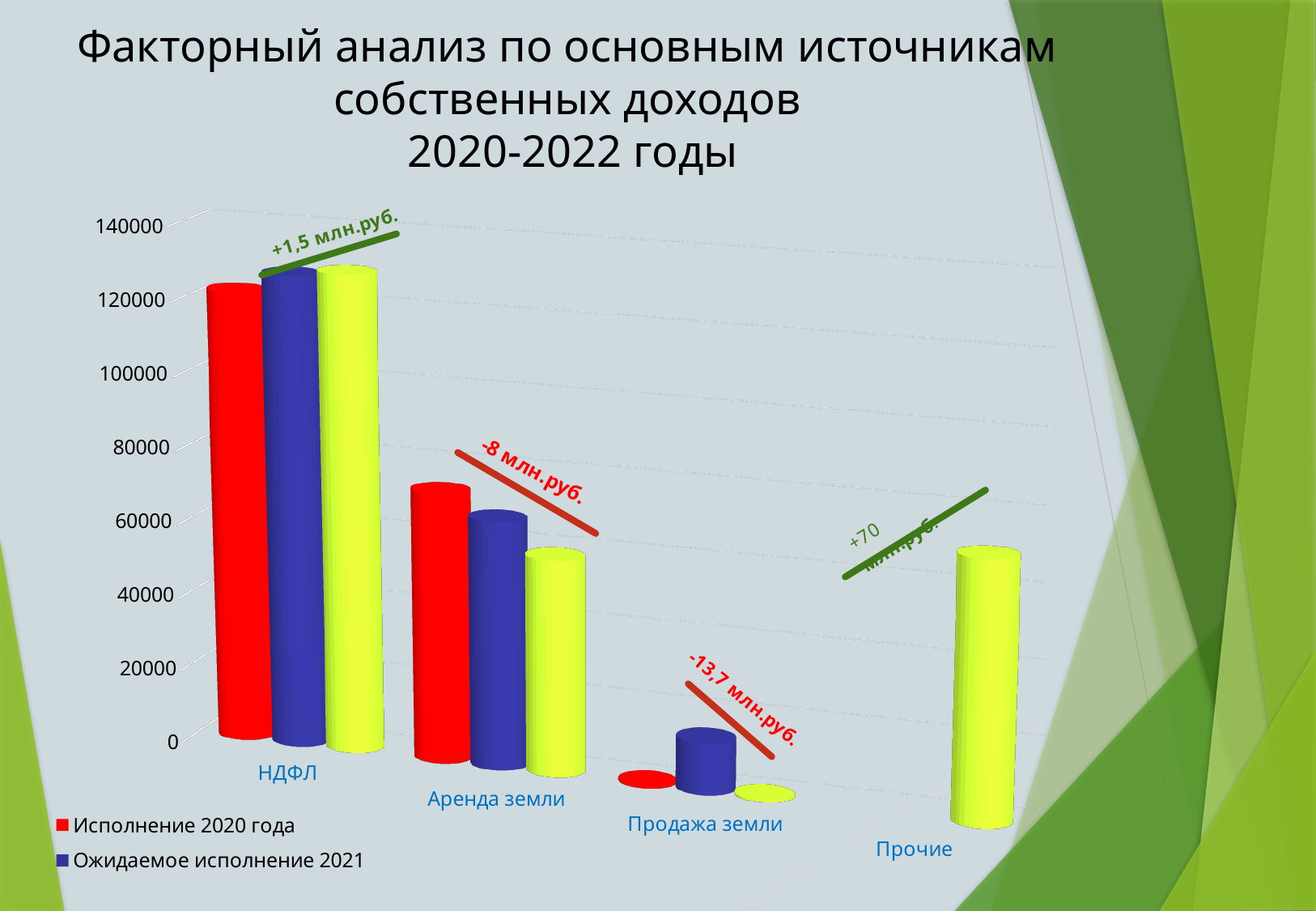
Is the value for Исполнение 2020 года for Аренда земли greater or less than 60000? greater How many categories are shown on the x axis of the chart? 4 Which category has the highest bars in the chart? НДФЛ How many series does the chart's legend list? 2 Which category has the lowest bars in the chart? Продажа земли Is the value for Исполнение 2020 года for НДФЛ greater or less than 100000? greater Do the Исполнение 2020 года values rise or fall from НДФЛ to Продажа земли? fall Is the value for Ожидаемое исполнение 2021 for Продажа земли greater or less than 20000? less What kind of chart is shown on the slide? bar chart What change is annotated above the Продажа земли bars? -13,7 млн.руб. Which is larger: the Исполнение 2020 года value for НДФЛ or for Аренда земли? НДФЛ What change is annotated above the НДФЛ bars? +1,5 млн.руб.